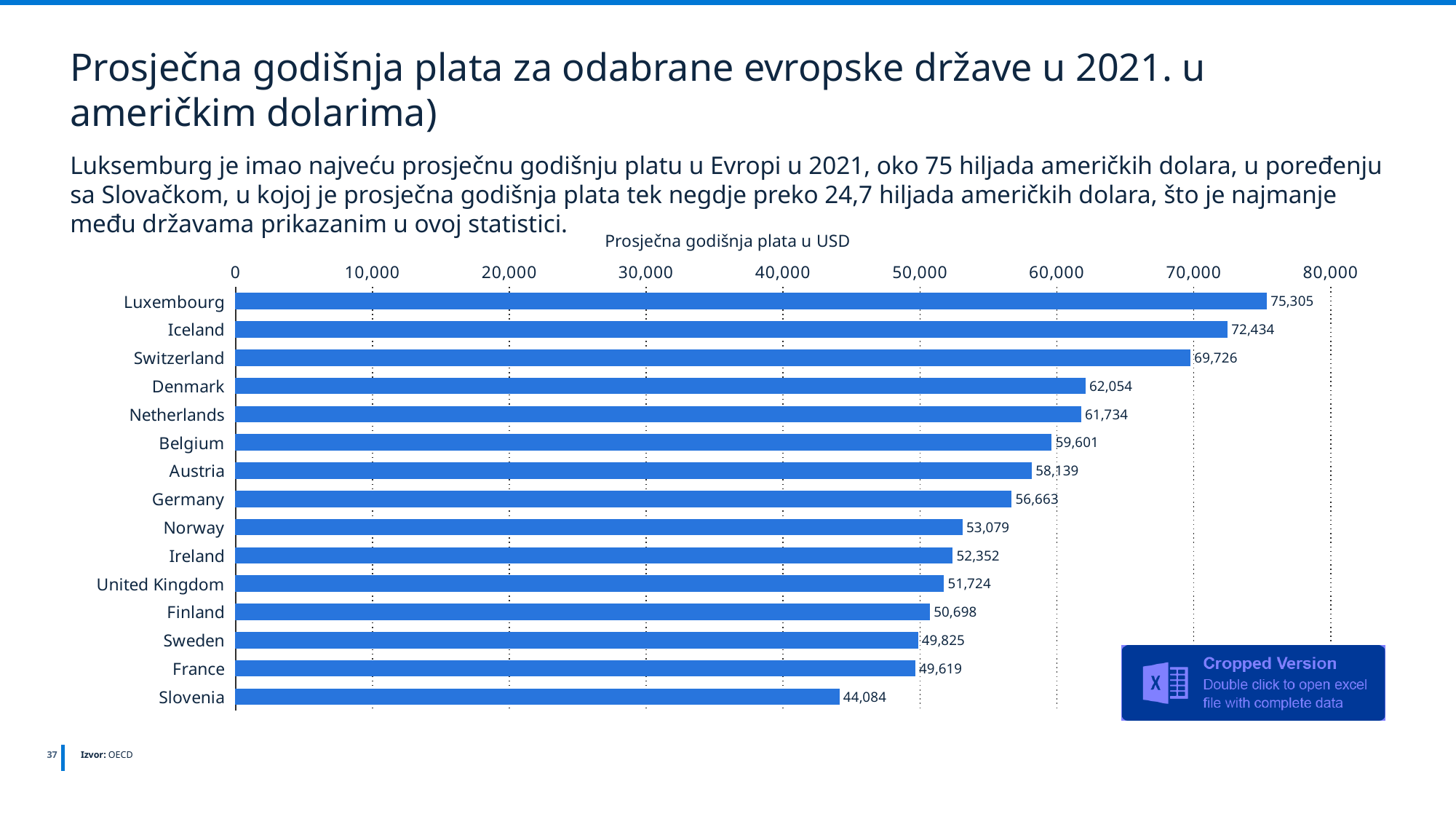
What is the average annual salary shown for Luxembourg? 75,305 What value is shown for Germany? 56,663 How many countries are shown in the chart? 15 What is the value for the United Kingdom? 51,724 What is the title of the chart? Prosječna godišnja plata u USD Which country has the highest average annual salary in the chart? Luxembourg Which country has the lowest value shown in the chart? Slovenia What is the difference between the values for Denmark and the Netherlands? 320 Which has a higher value, Norway or Ireland? Norway What type of chart is shown on the slide? Bar chart Is the value for Slovenia greater or less than 50,000? less What is the difference between the values for Luxembourg and Iceland? 2,871